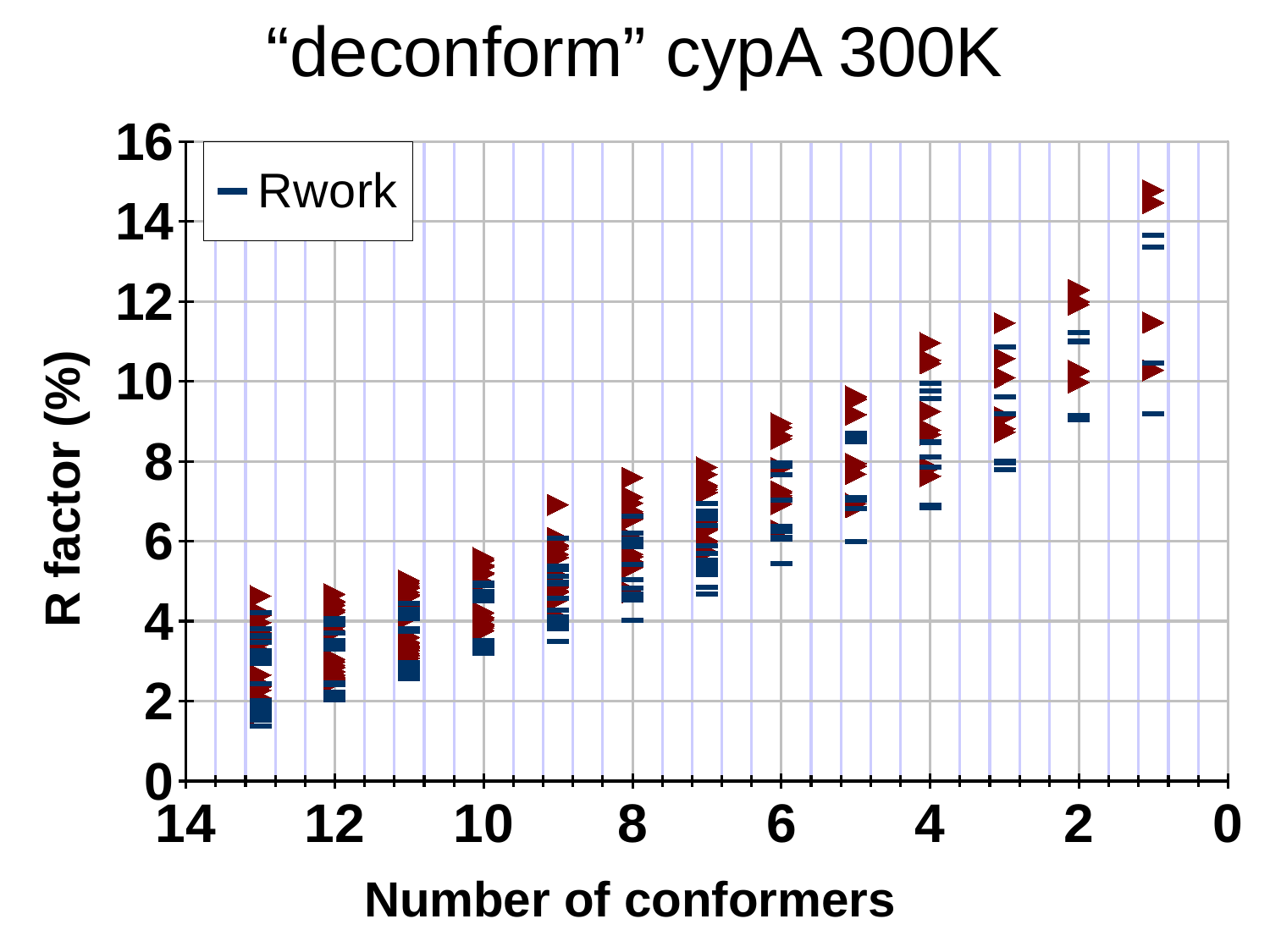
What is the title of the chart? "deconform" cypA 300K Which has higher red triangle values: 1 conformer or 13 conformers? 1 conformer What kind of chart is shown on the slide? scatter plot Is the highest red triangle value at 6 conformers greater or less than 8? greater Is the lowest Rwork value at 4 conformers greater or less than 8? less How many distinct numbers of conformers have data points plotted? 13 Are all the R factor values at 13 conformers greater or less than 6? less What is the highest value shown on the y axis? 16 What is the label of the y axis? R factor (%) How many series does the legend list? 1 Do the R factor values rise or fall as the number of conformers decreases from 13 to 1? rise